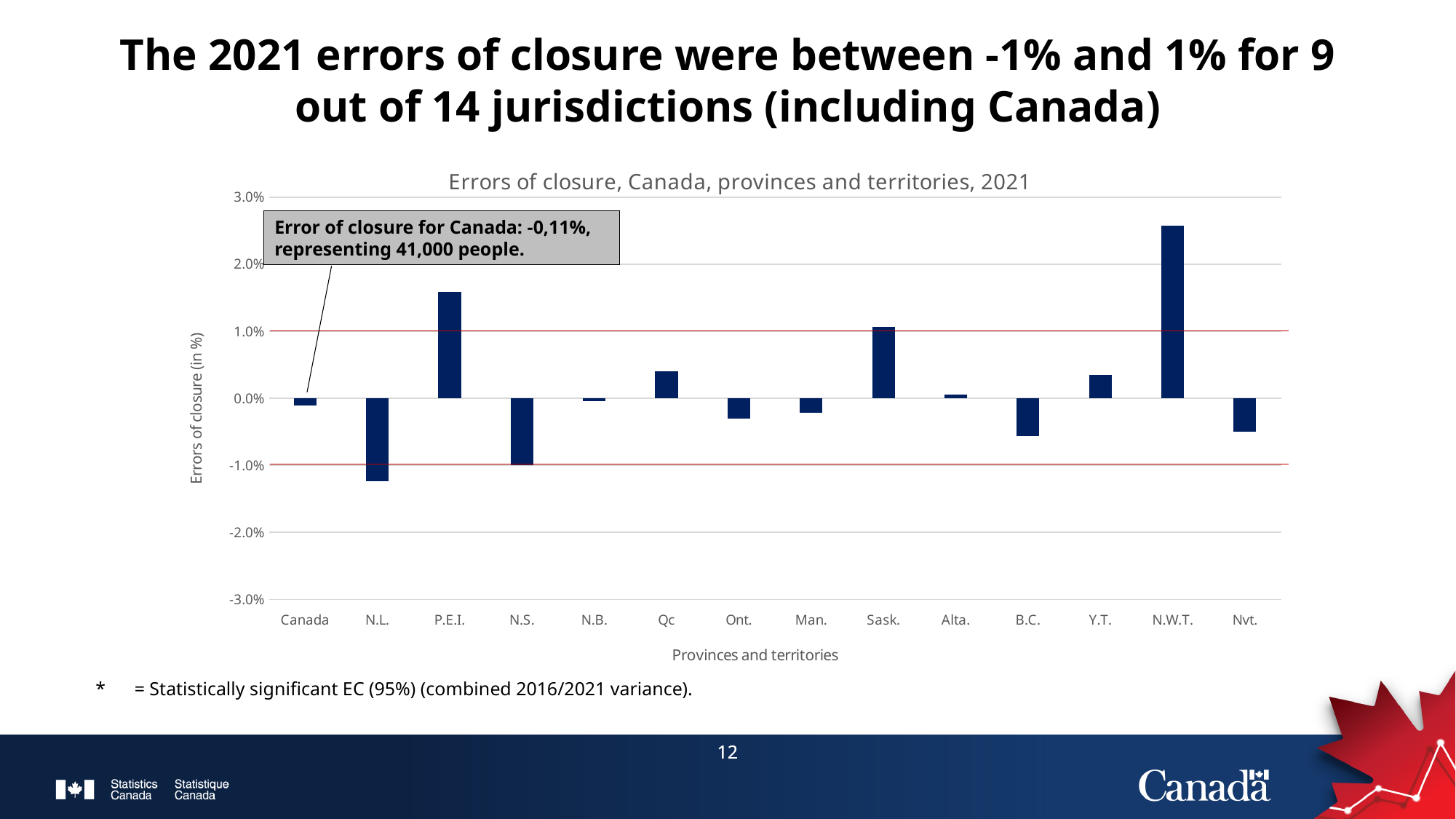
Is the error of closure for Qc greater or less than 1.0%? less Which jurisdiction has the highest error of closure? N.W.T. What is the error of closure for Canada, as stated in the callout box? -0,11% Is the error of closure for P.E.I. greater or less than 1.0%? greater What is the label of the y axis? Errors of closure (in %) Which has the larger error of closure, P.E.I. or Qc? P.E.I. How many jurisdictions (categories) are plotted on the x axis? 14 What type of chart is shown on the slide? bar chart Is the error of closure for N.W.T. greater or less than 2.0%? greater Which jurisdiction has the lowest error of closure? N.L. What is the title of the chart? Errors of closure, Canada, provinces and territories, 2021